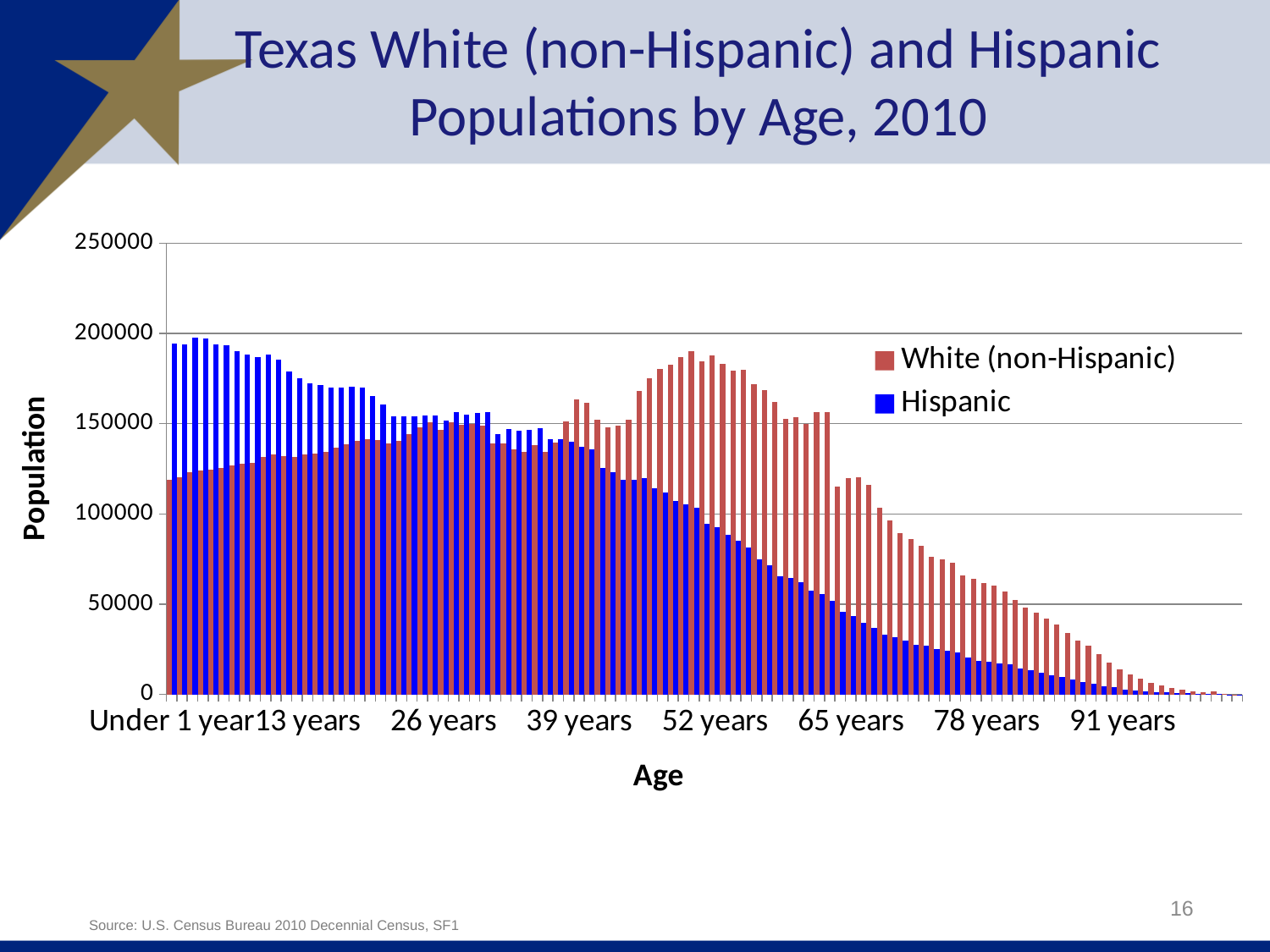
Is the White (non-Hispanic) value for 65 years greater or less than 100000? greater Which colour represents the Hispanic series in the chart? blue Is the White (non-Hispanic) value for 52 years greater or less than 150000? greater How many series does the legend list? 2 What is the title of the chart? Texas White (non-Hispanic) and Hispanic Populations by Age, 2010 At 65 years, which series has the larger value, White (non-Hispanic) or Hispanic? White (non-Hispanic) Is the Hispanic value for 78 years greater or less than 50000? less Do the Hispanic values rise or fall along the x axis from 13 years to 91 years? fall What kind of chart is shown on the slide? bar chart At Under 1 year, which series has the larger value, White (non-Hispanic) or Hispanic? Hispanic